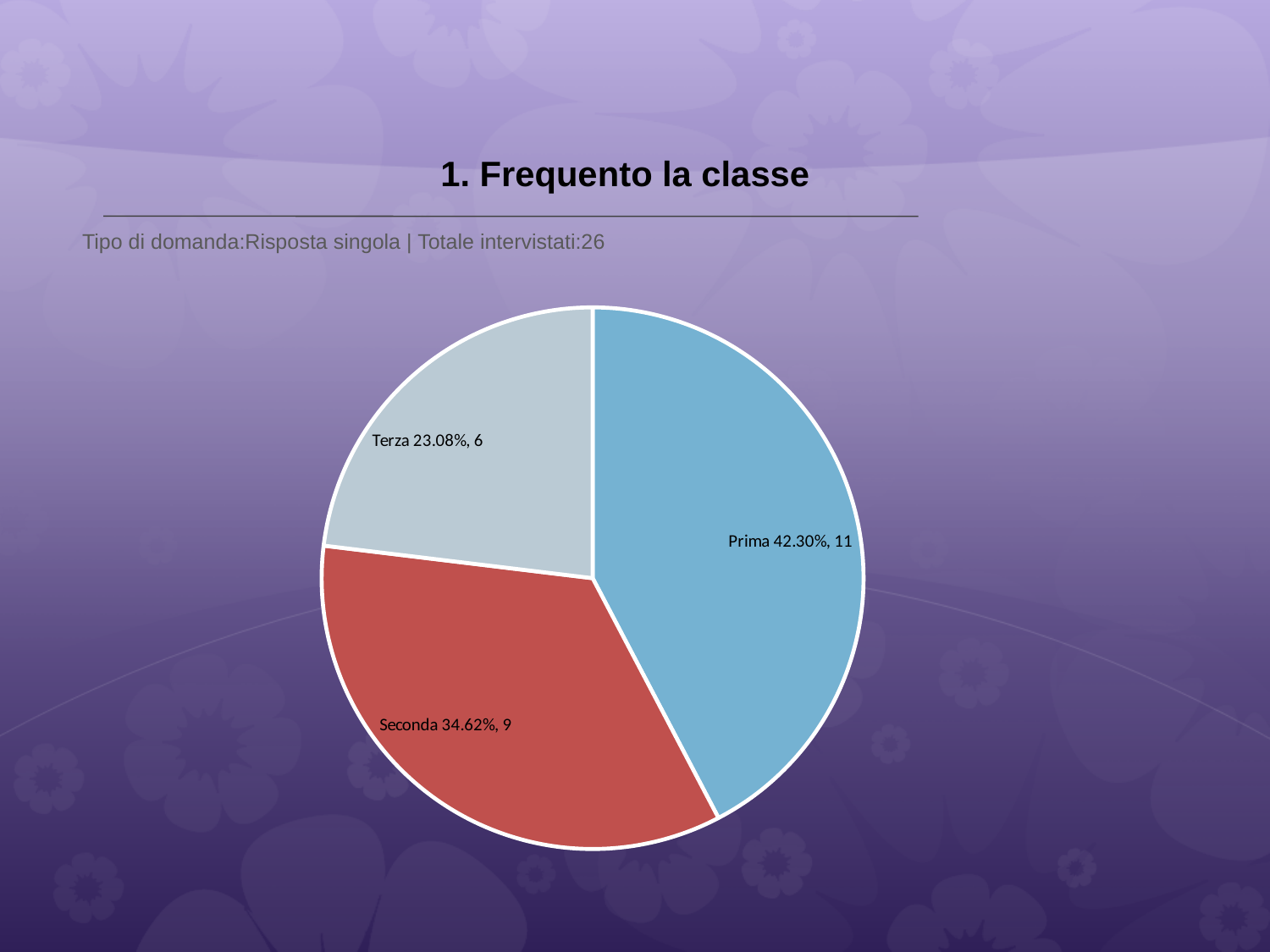
What share of the pie does Terza represent? 23.08% Which is larger, the count for Seconda or the count for Terza? Seconda What is the count for Terza? 6 What is the count for Seconda? 9 How many slices does the pie chart have? 3 What kind of chart is shown on the slide? pie chart Which category has the largest slice? Prima What is the title of the chart? 1. Frequento la classe What share of the pie does Seconda represent? 34.62% What is the count for Prima? 11 Which category has the smallest slice? Terza What is the difference in count between Prima and Terza? 5